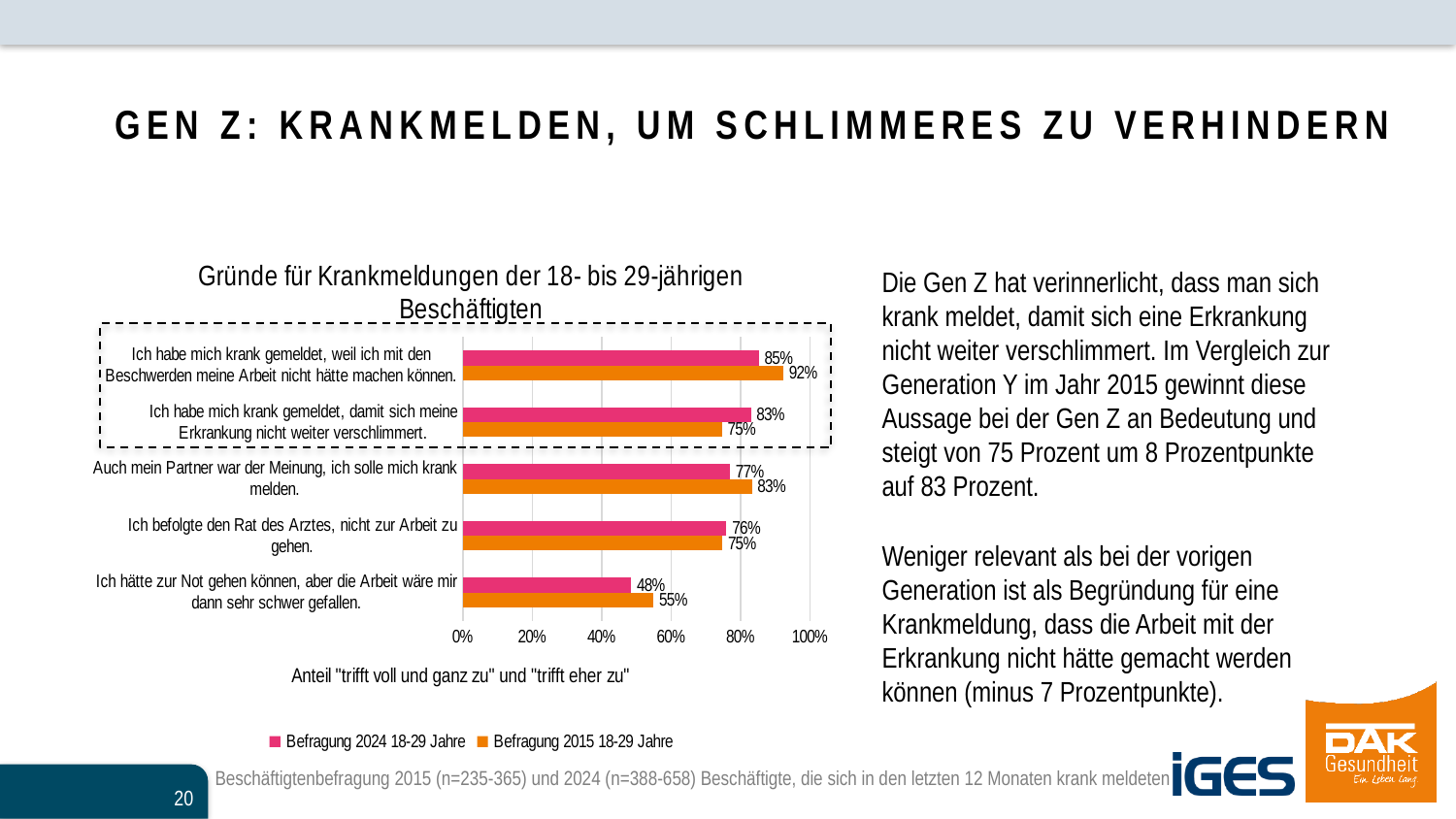
For 'Auch mein Partner war der Meinung, ich solle mich krank melden.', which survey has the larger value, 2024 or 2015? Befragung 2015 18-29 Jahre What is the value for 'Befragung 2024 18-29 Jahre' for the reason 'Ich habe mich krank gemeldet, damit sich meine Erkrankung nicht weiter verschlimmert.'? 83% How many categories (reasons) are shown in the chart? 5 How many series does the chart legend list? 2 What is the difference between the 2024 and 2015 values for 'Ich hätte zur Not gehen können, aber die Arbeit wäre mir dann sehr schwer gefallen.'? 7 percentage points Which reason has the lowest value in the 'Befragung 2015 18-29 Jahre' series? Ich hätte zur Not gehen können, aber die Arbeit wäre mir dann sehr schwer gefallen. Which reason has the highest value in the 'Befragung 2024 18-29 Jahre' series? Ich habe mich krank gemeldet, weil ich mit den Beschwerden meine Arbeit nicht hätte machen können. What is the value for 'Befragung 2015 18-29 Jahre' for the reason 'Ich habe mich krank gemeldet, weil ich mit den Beschwerden meine Arbeit nicht hätte machen können.'? 92% What is the difference between the 2015 and 2024 values for 'Ich habe mich krank gemeldet, weil ich mit den Beschwerden meine Arbeit nicht hätte machen können.'? 7 percentage points What is the value for 'Befragung 2024 18-29 Jahre' for the reason 'Ich hätte zur Not gehen können, aber die Arbeit wäre mir dann sehr schwer gefallen.'? 48% What is the title of the chart? Gründe für Krankmeldungen der 18- bis 29-jährigen Beschäftigten What type of chart is shown on the slide? bar chart